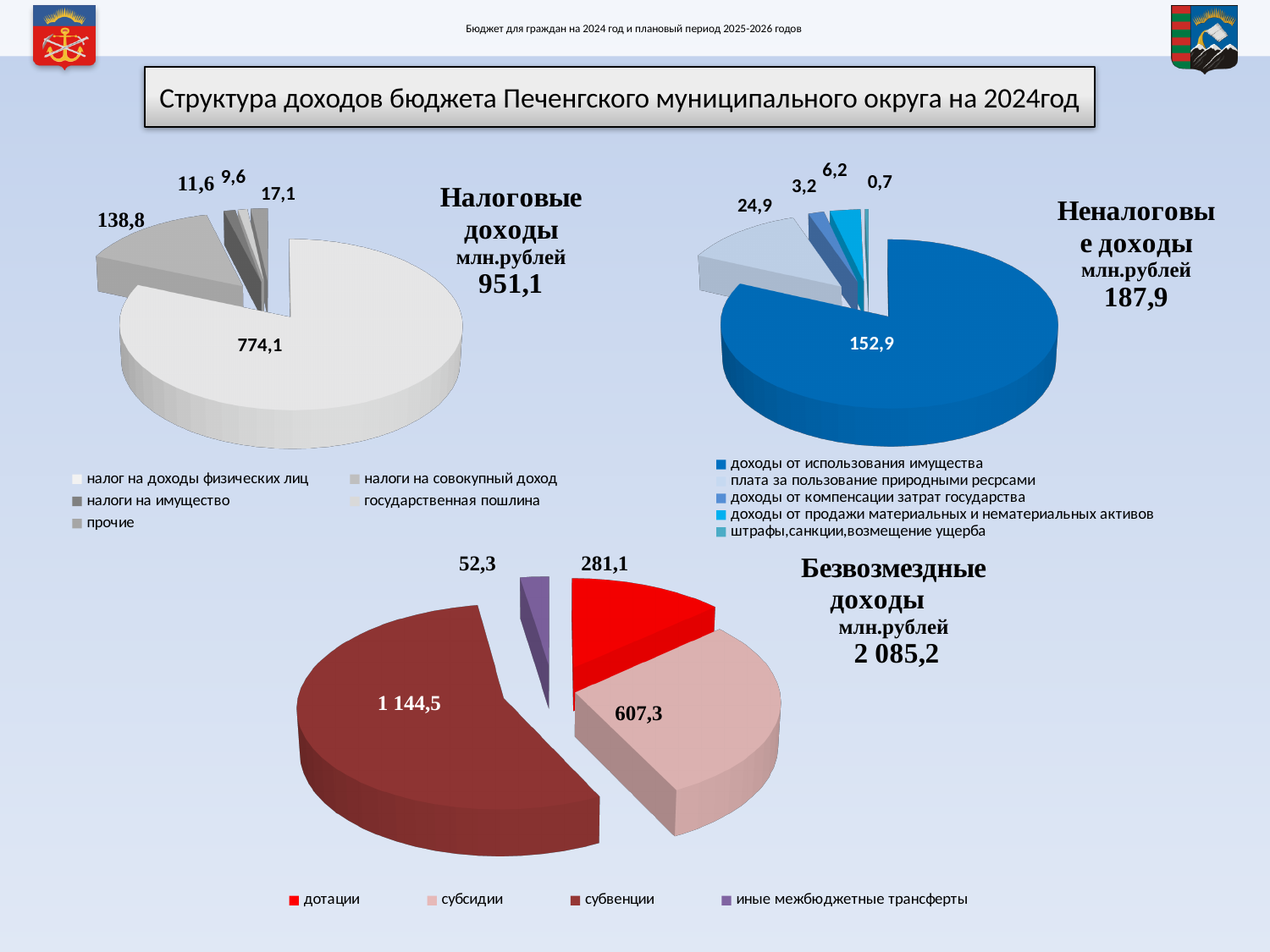
In the 'Безвозмездные доходы' pie chart, which category has the largest slice? субвенции In the 'Безвозмездные доходы' pie chart, what is the difference between субсидии and дотации? 326,2 In the 'Налоговые доходы' pie chart, what is the value for налог на доходы физических лиц? 774,1 In the 'Безвозмездные доходы' pie chart, which category has the smallest slice? иные межбюджетные трансферты In the 'Налоговые доходы' pie chart, which is larger: налог на доходы физических лиц or налоги на совокупный доход? налог на доходы физических лиц How many categories does the legend of the 'Неналоговые доходы' pie chart list? 5 How many slices does the 'Безвозмездные доходы' pie chart have? 4 In the 'Безвозмездные доходы' pie chart, what is the value for дотации? 281,1 In the 'Налоговые доходы' pie chart, which category has the largest slice? налог на доходы физических лиц In the 'Безвозмездные доходы' pie chart, what is the value for субвенции? 1 144,5 In the 'Неналоговые доходы' pie chart, what is the value for доходы от использования имущества? 152,9 What kind of chart is used for 'Налоговые доходы' on this slide? pie chart